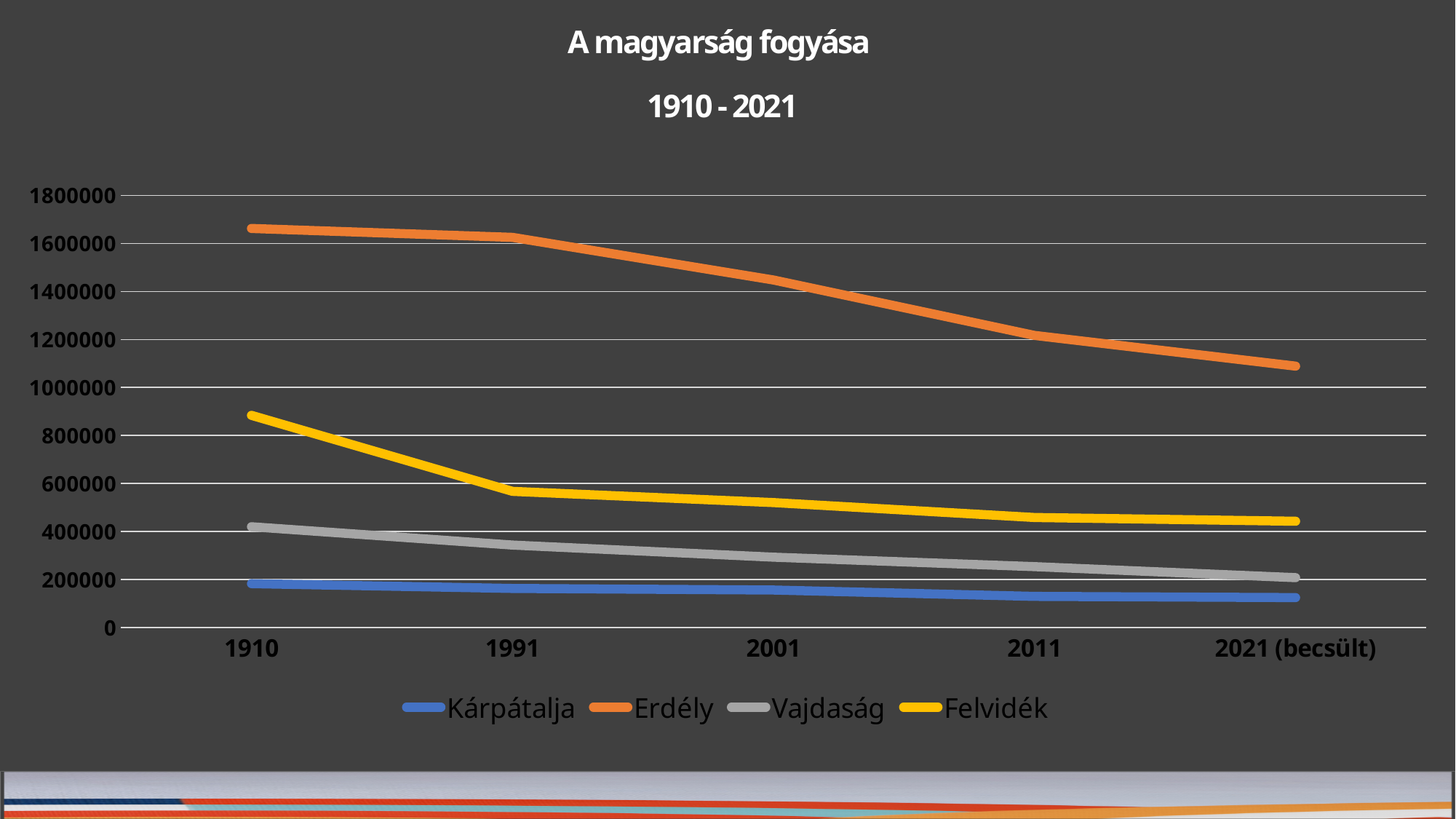
Which series has the lowest values across the whole chart? Kárpátalja Is the value for Kárpátalja in 2021 (becsült) greater or less than 200000? less How many series does the legend list? 4 What is the title of the chart? A magyarság fogyása 1910 - 2021 Which series has the highest values across the whole chart? Erdély Do the values for Erdély rise or fall from 1910 to 2021 (becsült)? fall How many points are there along the x axis? 5 Is the value for Erdély in 2021 (becsült) greater or less than 1000000? greater Is the value for Felvidék in 1910 greater or less than 800000? greater What kind of chart is shown on the slide? line chart In 1910, which is larger: the value for Felvidék or the value for Vajdaság? Felvidék